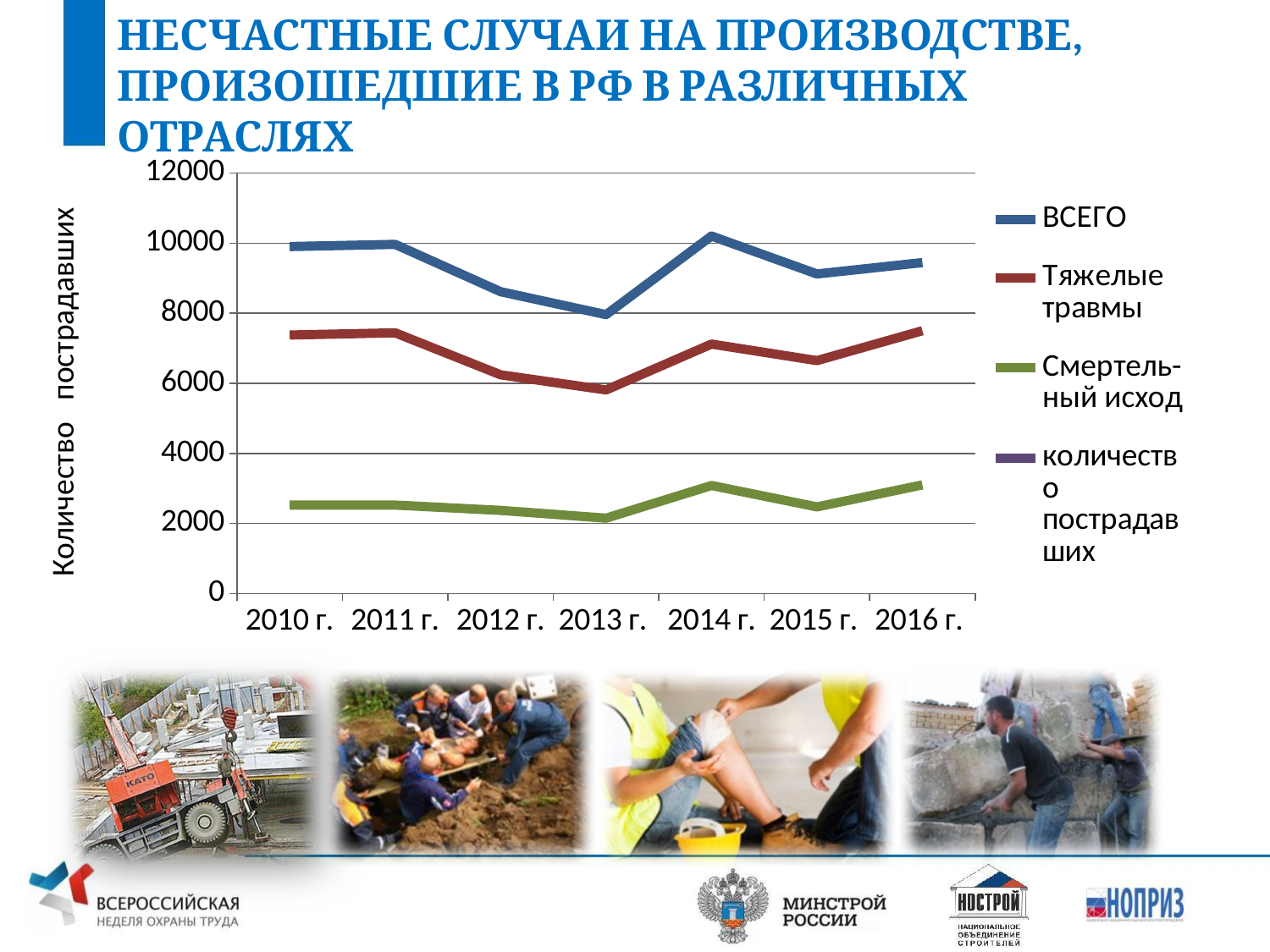
In which year is the value for ВСЕГО lowest? 2013 г. Does the value for ВСЕГО rise or fall from 2011 г. to 2013 г.? fall Is the value for Тяжелые травмы in 2013 г. greater or less than 6000? less What kind of chart is shown on the slide? line chart How many years are shown on the x axis of the chart? 7 In which year is the value for Смертельный исход lowest? 2013 г. Is the value for Смертельный исход in 2014 г. greater or less than 2000? greater In which year is the value for ВСЕГО highest? 2014 г. Which is larger: the value for ВСЕГО in 2010 г. or in 2013 г.? 2010 г. How many series does the chart legend list? 4 In which year is the value for Тяжелые травмы lowest? 2013 г. Is the value for ВСЕГО in 2010 г. greater or less than 8000? greater